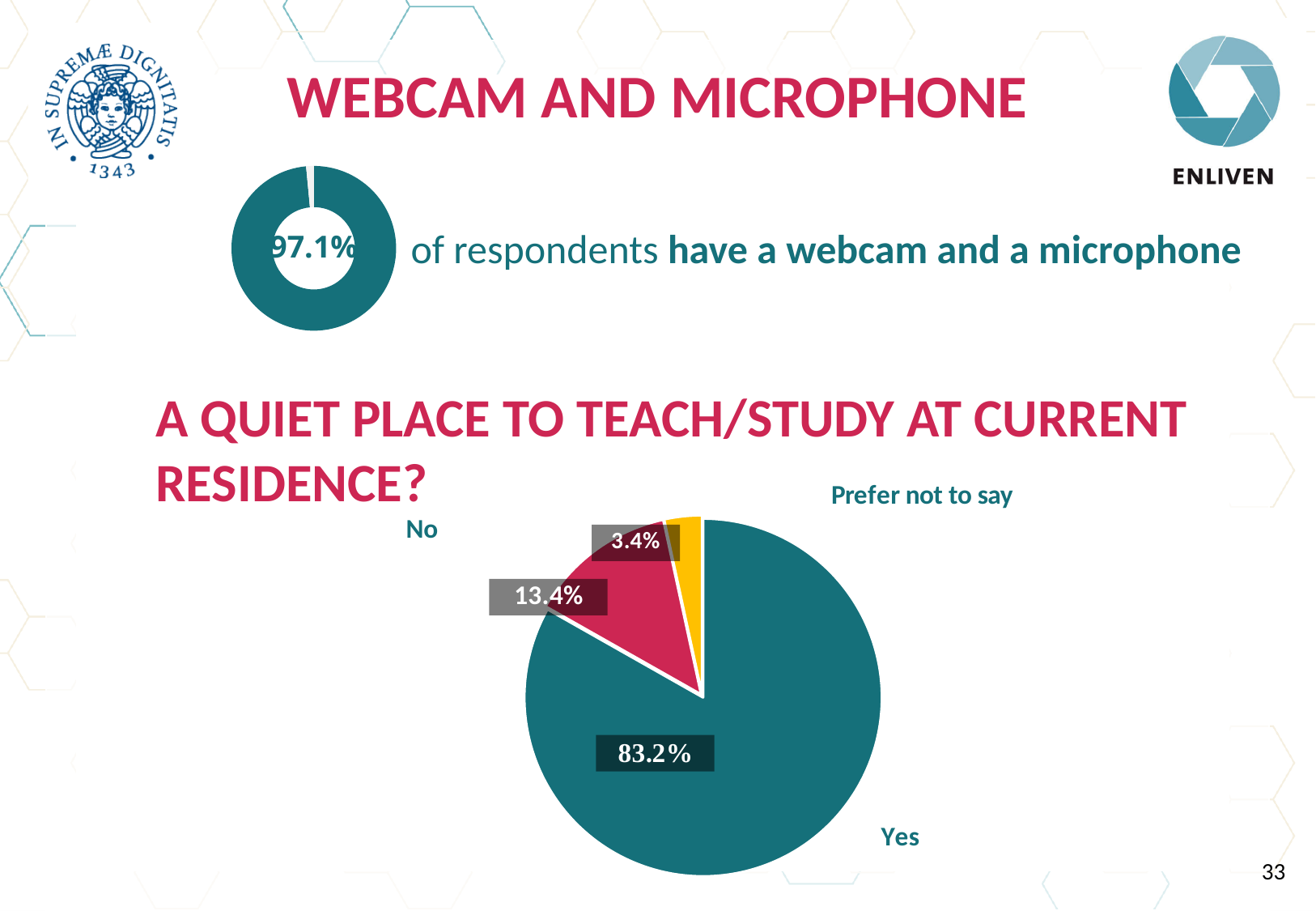
In the pie chart about a quiet place to teach/study, what share of respondents answered No? 13.4% In the pie chart about a quiet place to teach/study, which category has the largest slice? Yes In the pie chart about a quiet place to teach/study, which is larger: No or Prefer not to say? No In the pie chart about a quiet place to teach/study, what colour is the Prefer not to say slice? Yellow In the pie chart about a quiet place to teach/study, what colour is the Yes slice? Teal How many categories does the pie chart about a quiet place to teach/study show? 3 In the pie chart about a quiet place to teach/study, what share of respondents answered Yes? 83.2% In the pie chart about a quiet place to teach/study, what is the difference between the Yes and No shares? 69.8% In the donut chart at the top of the slide, what percentage of respondents have a webcam and a microphone? 97.1% In the pie chart about a quiet place to teach/study, which category has the smallest slice? Prefer not to say What kind of chart is used for the question about a quiet place to teach/study at current residence? Pie chart In the pie chart about a quiet place to teach/study, what share of respondents chose Prefer not to say? 3.4%